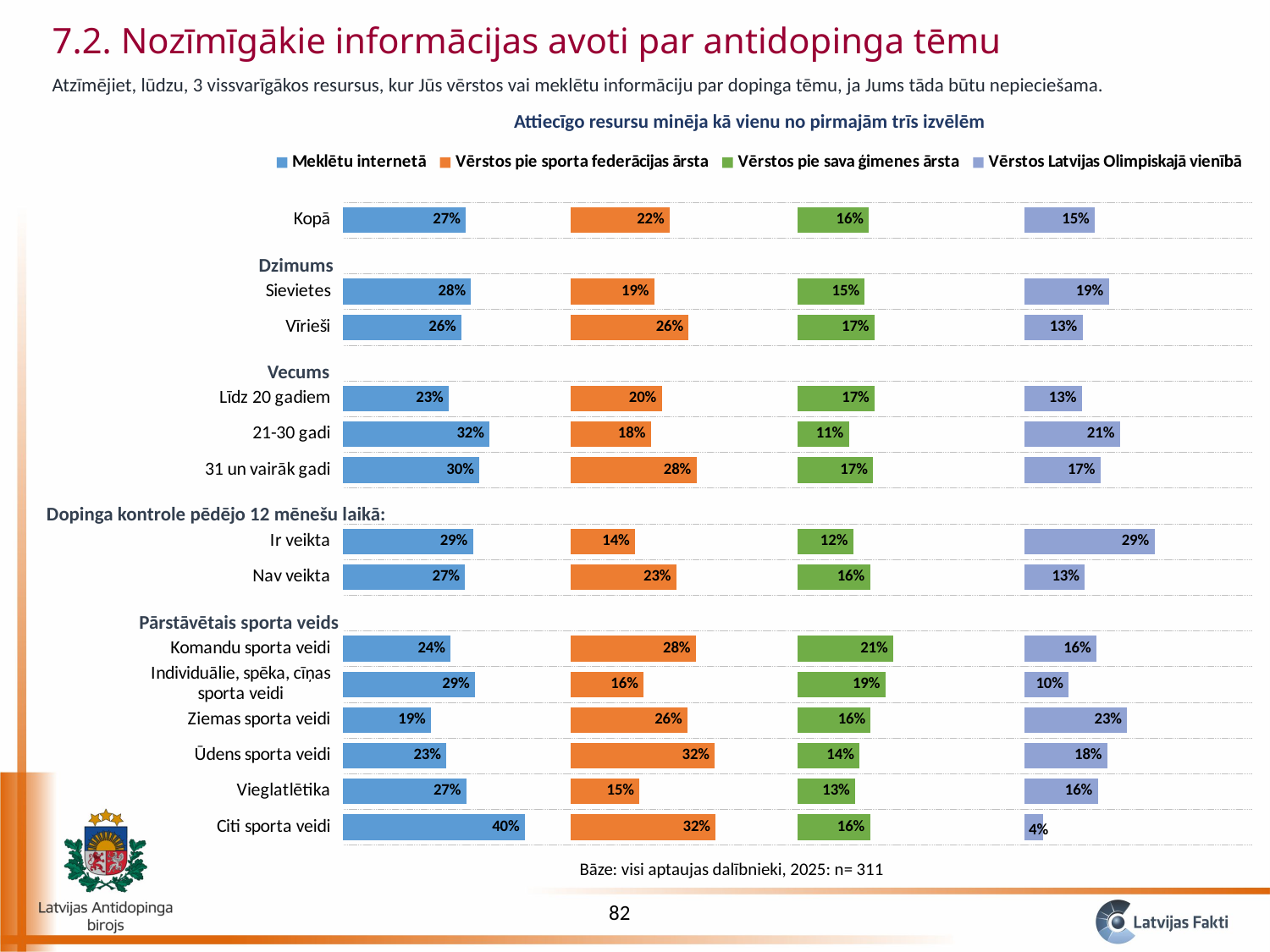
Which category has the lowest value in the Vērstos Latvijas Olimpiskajā vienībā series? Citi sporta veidi Which category has the highest value in the Meklētu internetā series? Citi sporta veidi What is the value for Kopā in the Meklētu internetā series? 27% What is the value for Komandu sporta veidi in the Vērstos pie sava ģimenes ārsta series? 21% What is the difference between the Meklētu internetā values for Citi sporta veidi and Ziemas sporta veidi? 21% How many series does the legend list? 4 What kind of chart is shown on the slide? Bar chart What is the value for Ir veikta in the Vērstos Latvijas Olimpiskajā vienībā series? 29% What colour are the bars for the Vērstos pie sava ģimenes ārsta series? Green How many categories are plotted in the chart? 14 What is the value for Ūdens sporta veidi in the Vērstos pie sporta federācijas ārsta series? 32% Which is larger for 21-30 gadi: the Meklētu internetā value or the Vērstos pie sporta federācijas ārsta value? Meklētu internetā